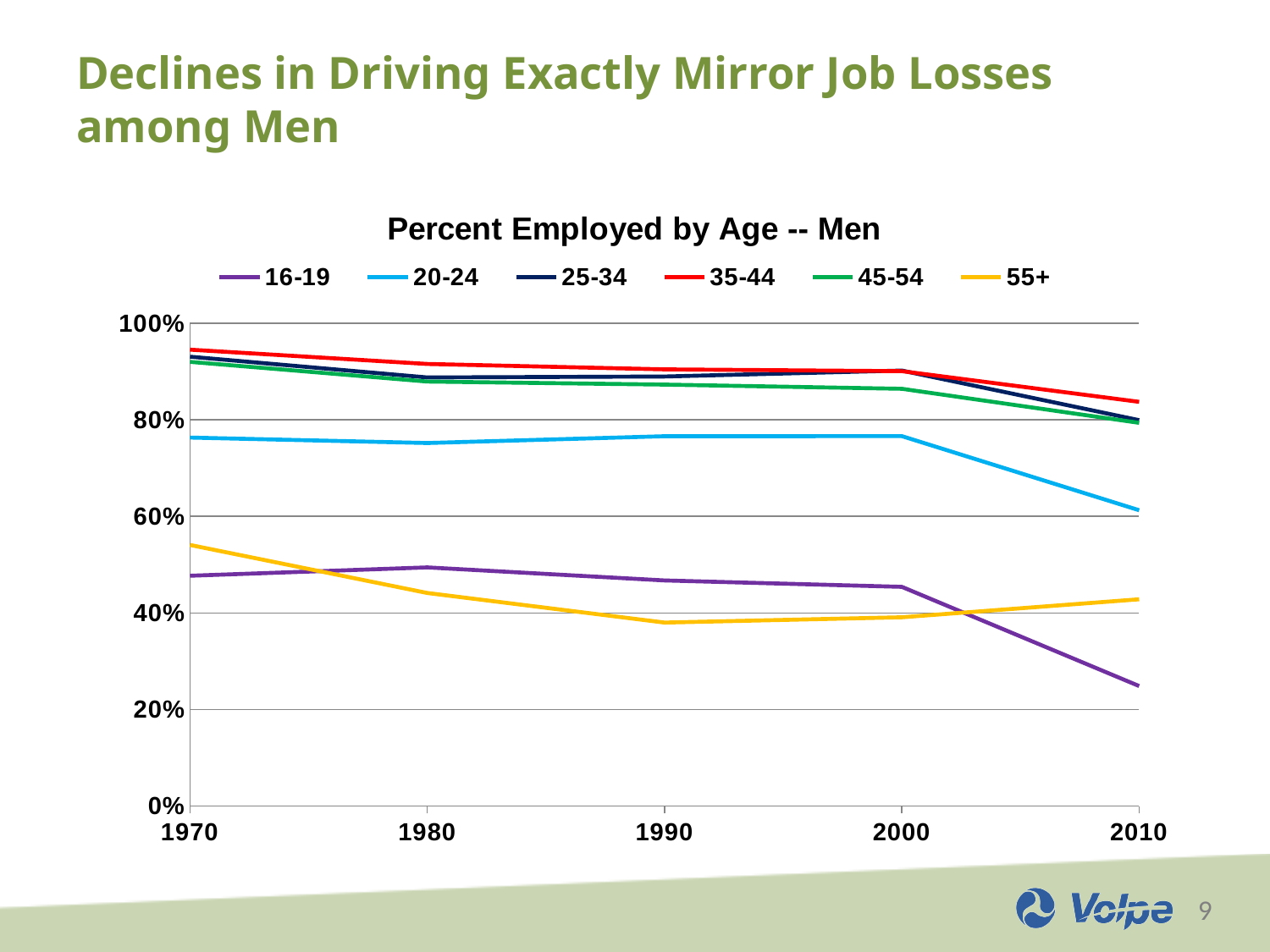
Does the 16-19 line rise or fall between 1970 and 2010? fall How many years are marked along the x axis? 5 Is the value for 20-24 in 2000 greater or less than 60%? greater Is the value for 35-44 in 1970 greater or less than 80%? greater What is the title of the chart? Percent Employed by Age -- Men Which series has the highest value in 1970? 35-44 How many series does the legend list? 6 What kind of chart is shown on the slide? line chart Does the 20-24 line rise or fall between 2000 and 2010? fall Is the value for 16-19 in 2010 greater or less than 40%? less In 2010, which is larger: the value for 16-19 or the value for 55+? 55+ Which series has the lowest value in 2010? 16-19